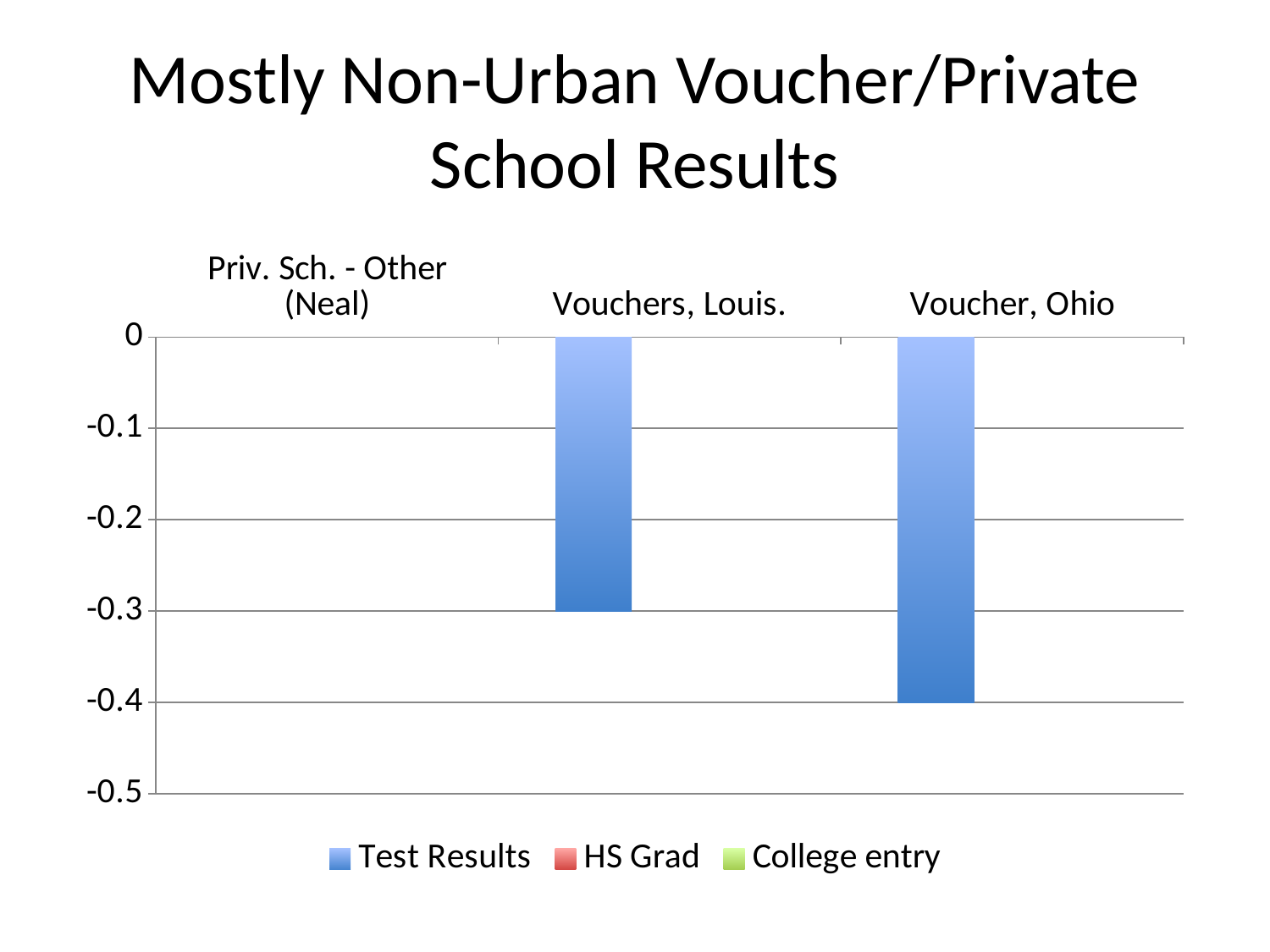
What is the Test Results value for Vouchers, Louis.? -0.3 What is the difference between the Test Results values for Vouchers, Louis. and Voucher, Ohio? 0.1 Is the Test Results value for Vouchers, Louis. greater or less than -0.4? greater How many categories are shown on the x axis of the chart? 3 What is the Test Results value for Voucher, Ohio? -0.4 What kind of chart is shown on the slide? bar chart What is the lowest value shown on the vertical axis of the chart? -0.5 What is the title of the slide containing the chart? Mostly Non-Urban Voucher/Private School Results Which has the larger Test Results value, Vouchers, Louis. or Voucher, Ohio? Vouchers, Louis. Is the Test Results value for Voucher, Ohio greater or less than -0.3? less Which category has the lowest Test Results value? Voucher, Ohio How many series does the legend list? 3